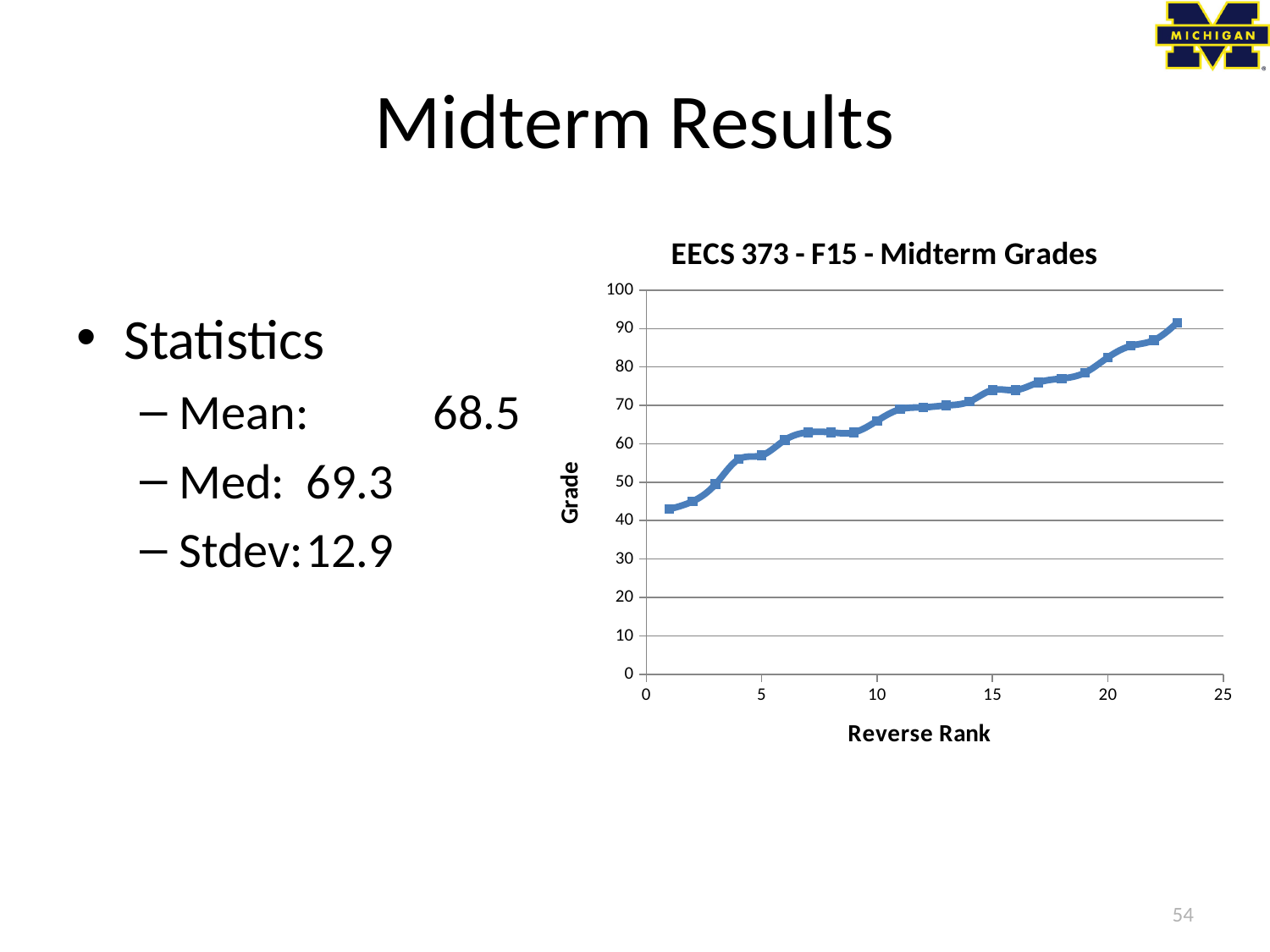
How many data points are plotted on the chart? 23 What kind of chart is shown on the slide? line chart Which has the larger Grade, Reverse Rank 10 or Reverse Rank 20? Reverse Rank 20 At which Reverse Rank is the Grade highest? 23 What is the title of the chart? EECS 373 - F15 - Midterm Grades Is the Grade at Reverse Rank 23 greater or less than 80? greater At which Reverse Rank is the Grade lowest? 1 Do the grades rise or fall as Reverse Rank increases? rise Is the Grade at Reverse Rank 15 greater or less than 70? greater Is the Grade at Reverse Rank 5 greater or less than 60? less What is the label of the x axis of the chart? Reverse Rank